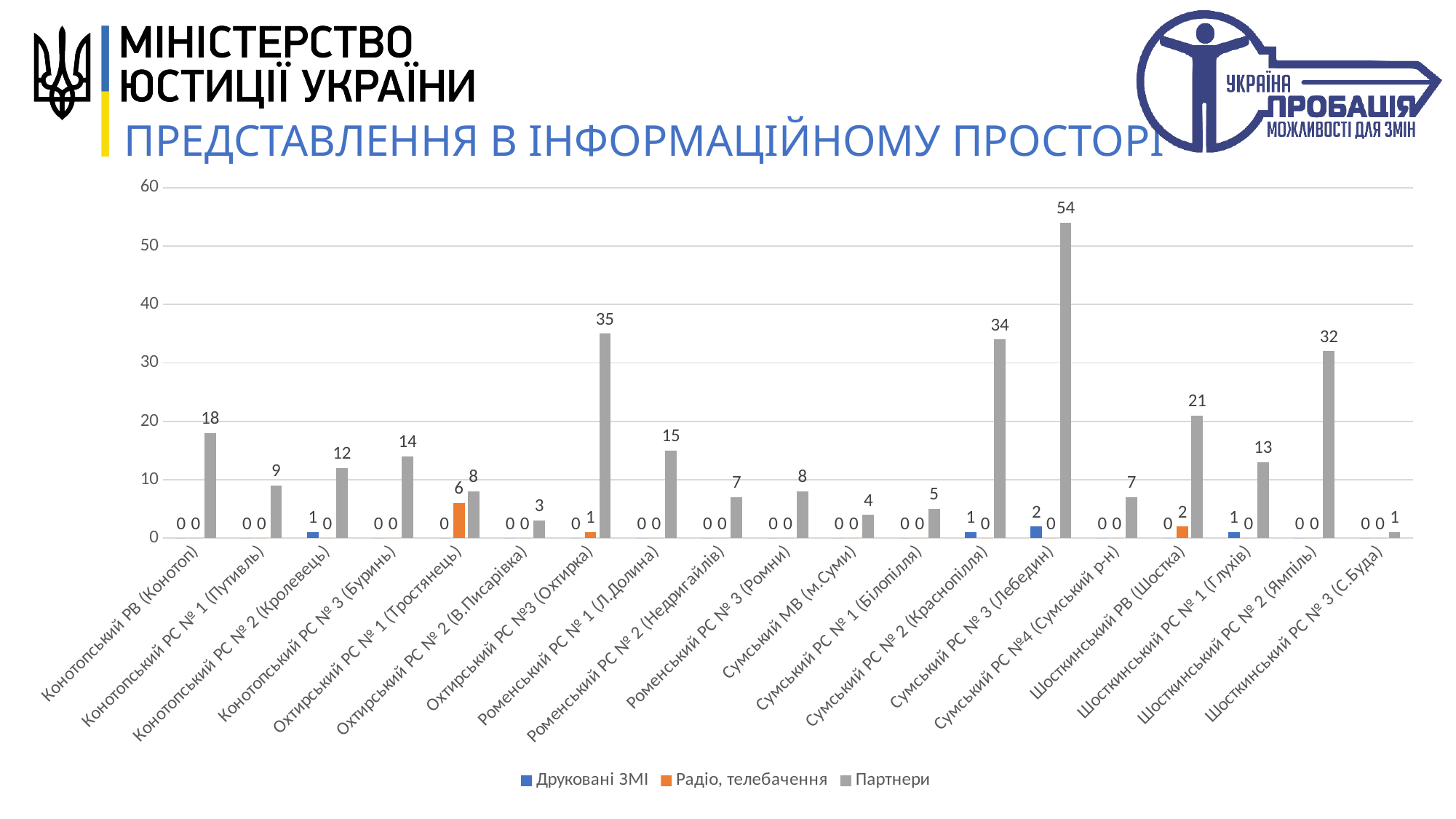
Which series is shown in orange in the legend? Радіо, телебачення What is the value of Партнери for Сумський РС № 3 (Лебедин)? 54 What is the value of Партнери for Шосткинський РС № 2 (Ямпіль)? 32 Which category has the lowest Партнери value? Шосткинський РС № 3 (С.Буда) What type of chart is shown on the slide? bar chart Which category has the highest Партнери value? Сумський РС № 3 (Лебедин) How many categories are shown on the x axis? 19 What is the value of Друковані ЗМІ for Сумський РС № 3 (Лебедин)? 2 What is the value of Радіо, телебачення for Охтирський РС № 1 (Тростянець)? 6 What is the difference between the Партнери values for Охтирський РС №3 (Охтирка) and Сумський РС № 2 (Краснопілля)? 1 Which is larger: the Партнери value for Конотопський РВ (Конотоп) or for Шосткинський РВ (Шостка)? Шосткинський РВ (Шостка) How many series does the legend list? 3